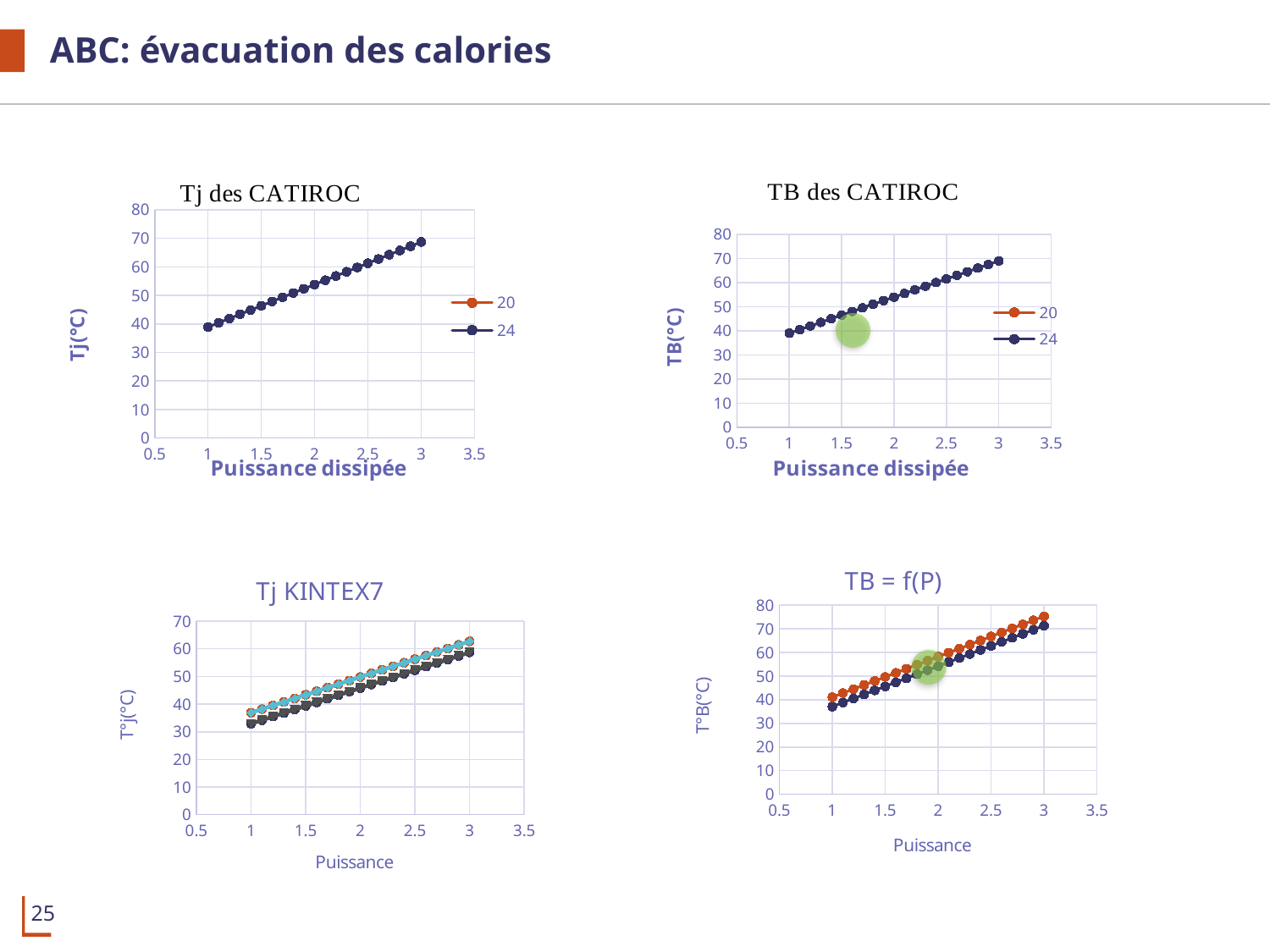
In the 'TB des CATIROC' chart, do the values rise or fall along the x axis? rise In the 'Tj KINTEX7' chart, are the values at Puissance 3 greater or less than 50? greater In the 'Tj KINTEX7' chart, are the values at Puissance 1 greater or less than 40? less In the 'TB = f(P)' chart, are the values at Puissance 1 greater or less than 50? less In the 'Tj des CATIROC' chart, do the values rise or fall as Puissance dissipée increases? rise What are the two entries in the legend of the 'TB des CATIROC' chart? 20 and 24 What is the x-axis label of the 'TB = f(P)' chart? Puissance What kind of chart is the 'Tj des CATIROC' chart? line chart In the 'TB = f(P)' chart, do the values rise or fall as Puissance increases? rise How many series does the legend of the 'Tj des CATIROC' chart list? 2